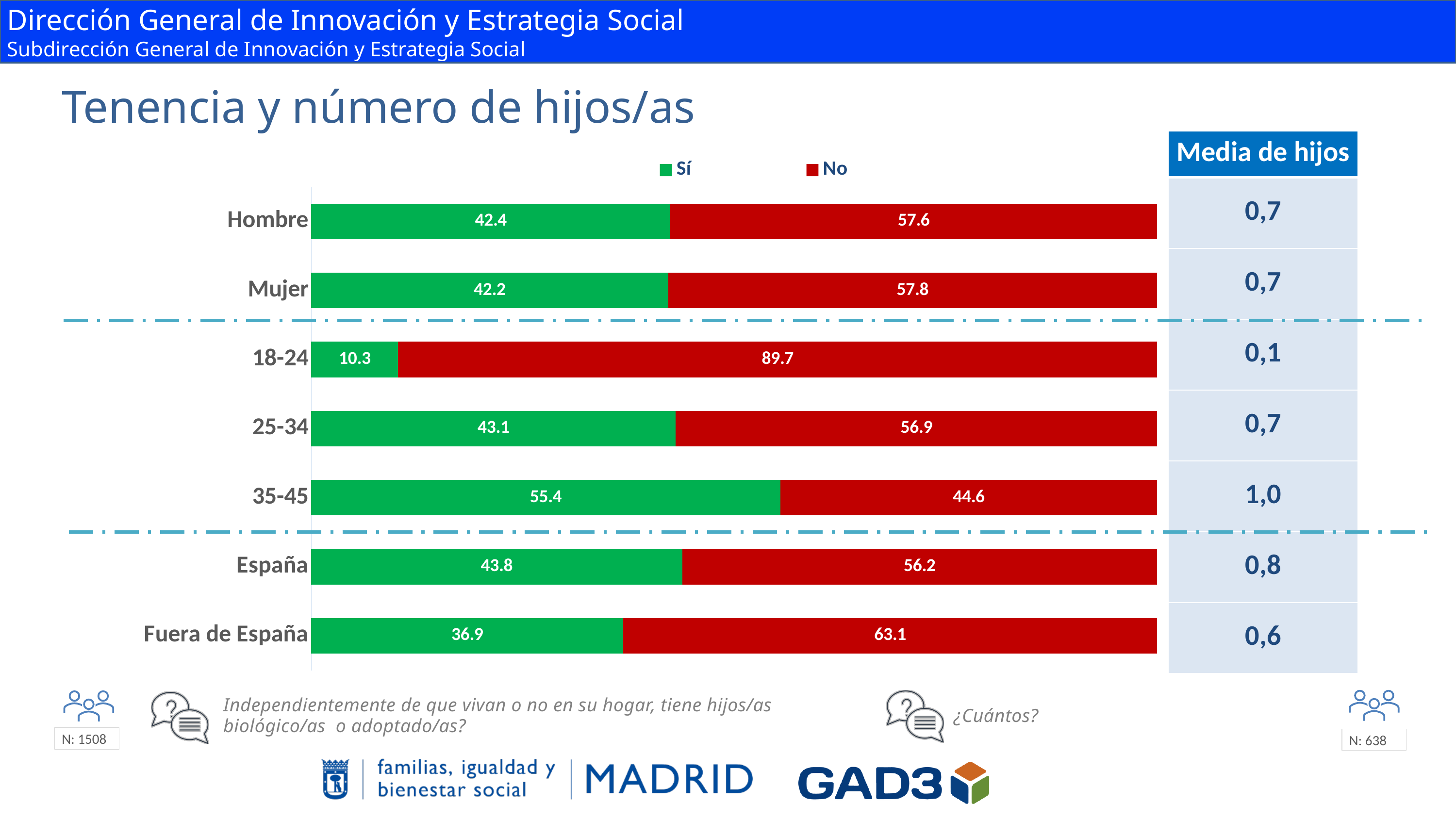
What is the difference between the "No" value for 18-24 and the "No" value for 35-45? 45.1 Which colour represents the "No" series in the chart? Red Which category has the highest "Sí" value? 35-45 What is the "No" value for 18-24? 89.7 What is the total of the stacked bar for 25-34? 100 Which has a larger "Sí" value, España or Fuera de España? España How many categories are shown in the bar chart? 7 What is the "Sí" value for Hombre? 42.4 What kind of chart is shown on the slide? Stacked bar chart Which category has the lowest "Sí" value? 18-24 What is the "Sí" value for Fuera de España? 36.9 How many series does the legend list? 2